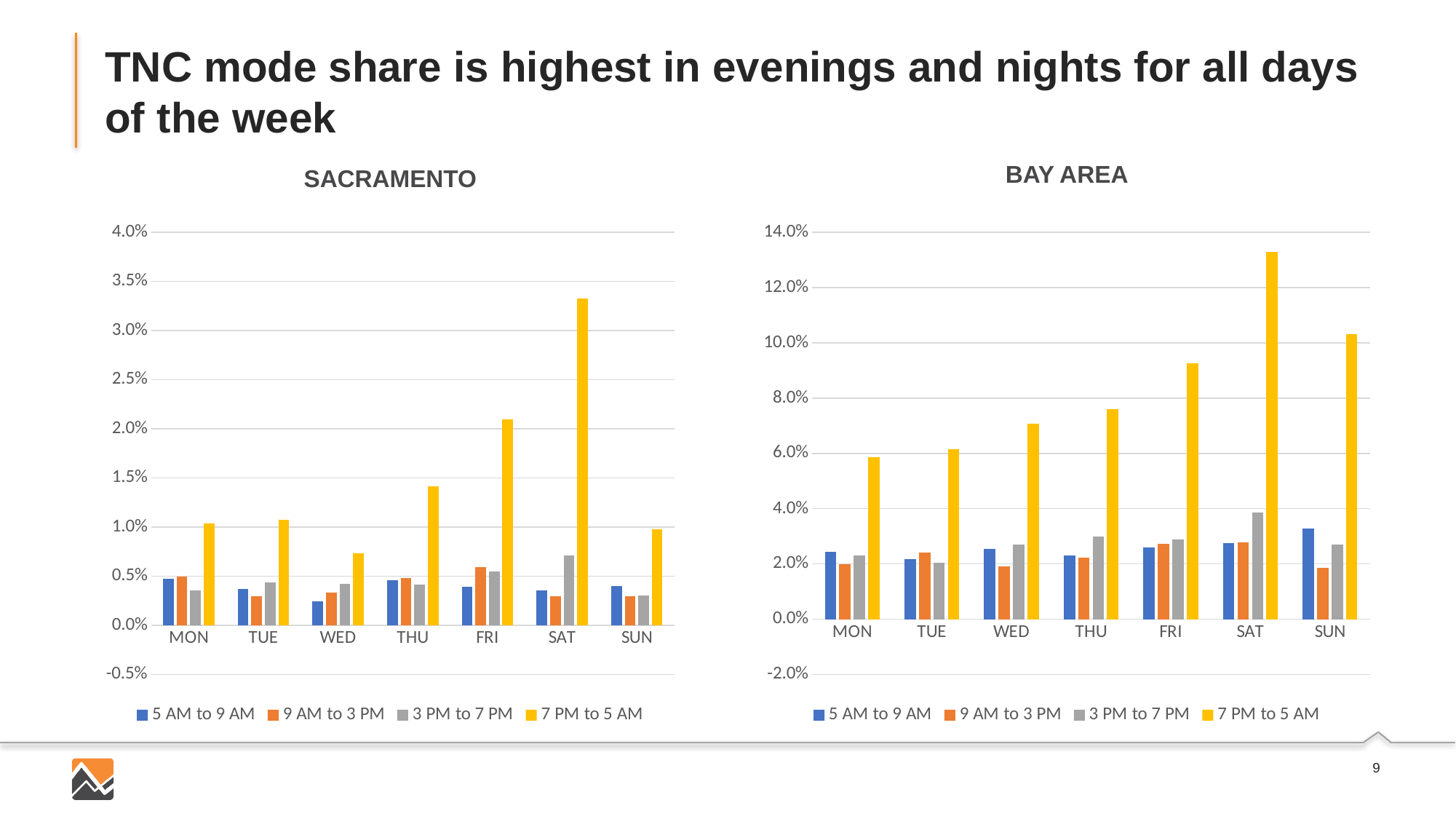
In the SACRAMENTO chart, which day has the highest value for the 7 PM to 5 AM series? SAT In the BAY AREA chart, is the 7 PM to 5 AM value for WED greater or less than 6.0%? greater In the BAY AREA chart, is the 7 PM to 5 AM value for FRI greater or less than 8.0%? greater In the BAY AREA chart, is the 7 PM to 5 AM value for SAT greater or less than 12.0%? greater In the BAY AREA chart, which day has the highest value for the 7 PM to 5 AM series? SAT How many days are shown on the x axis of the SACRAMENTO chart? 7 In the BAY AREA chart, which is larger for the 7 PM to 5 AM series: SAT or SUN? SAT In the SACRAMENTO chart, which day has the lowest value for the 7 PM to 5 AM series? WED What kind of chart is the BAY AREA chart? bar chart How many series does the legend of the BAY AREA chart list? 4